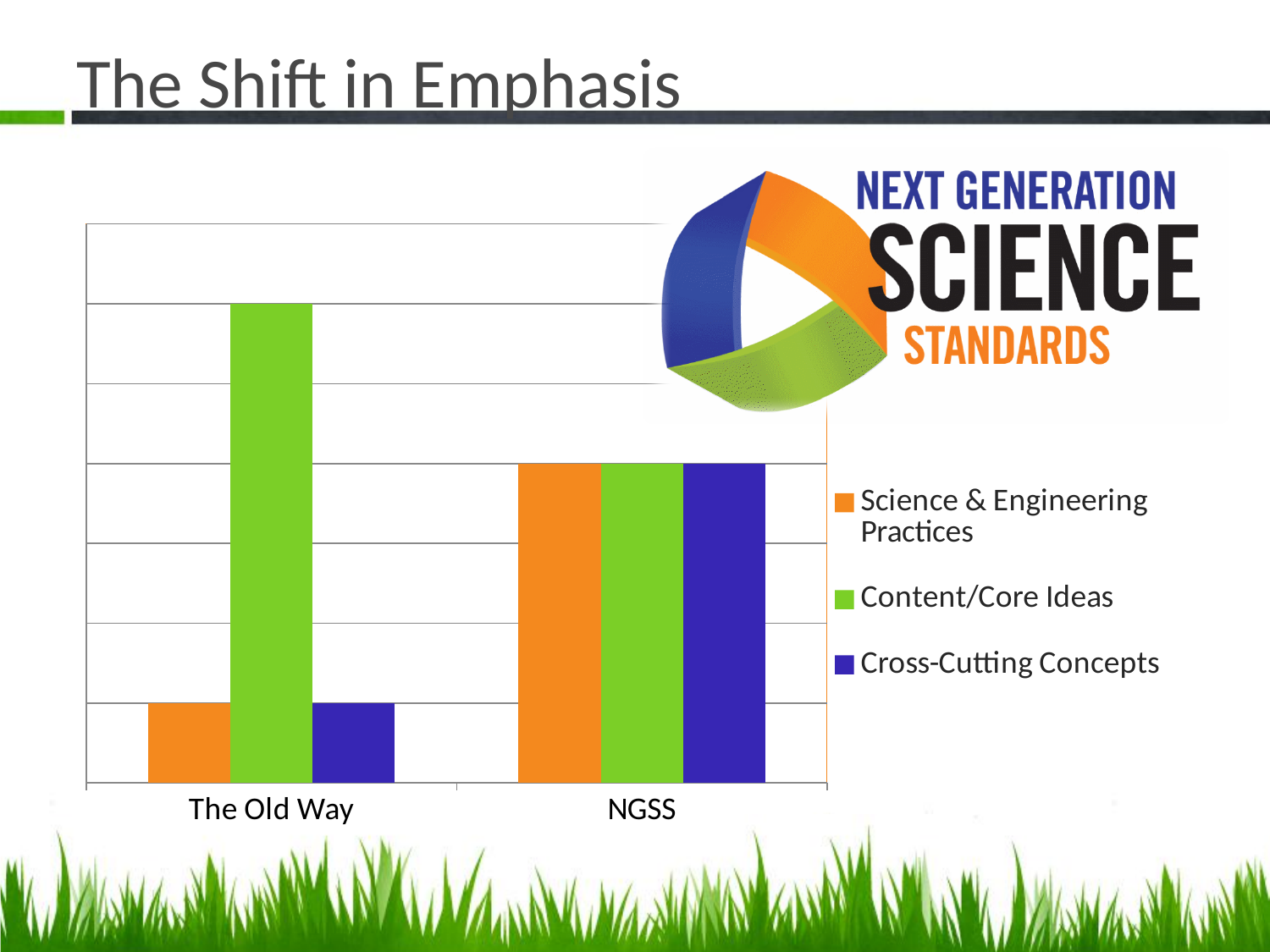
Which colour represents Cross-Cutting Concepts in the chart's legend? blue What kind of chart is shown on the slide? bar chart What are the two category labels on the x axis of the chart? The Old Way and NGSS Is the Science & Engineering Practices bar higher for The Old Way or for NGSS? NGSS How many series does the chart's legend list? 3 Which series has the highest value for The Old Way? Content/Core Ideas For The Old Way, is the value for Content/Core Ideas larger or smaller than the value for Science & Engineering Practices? larger Is the Content/Core Ideas bar higher for The Old Way or for NGSS? The Old Way Which series is shown in orange in the chart? Science & Engineering Practices How many categories are shown on the x axis of the chart? 2